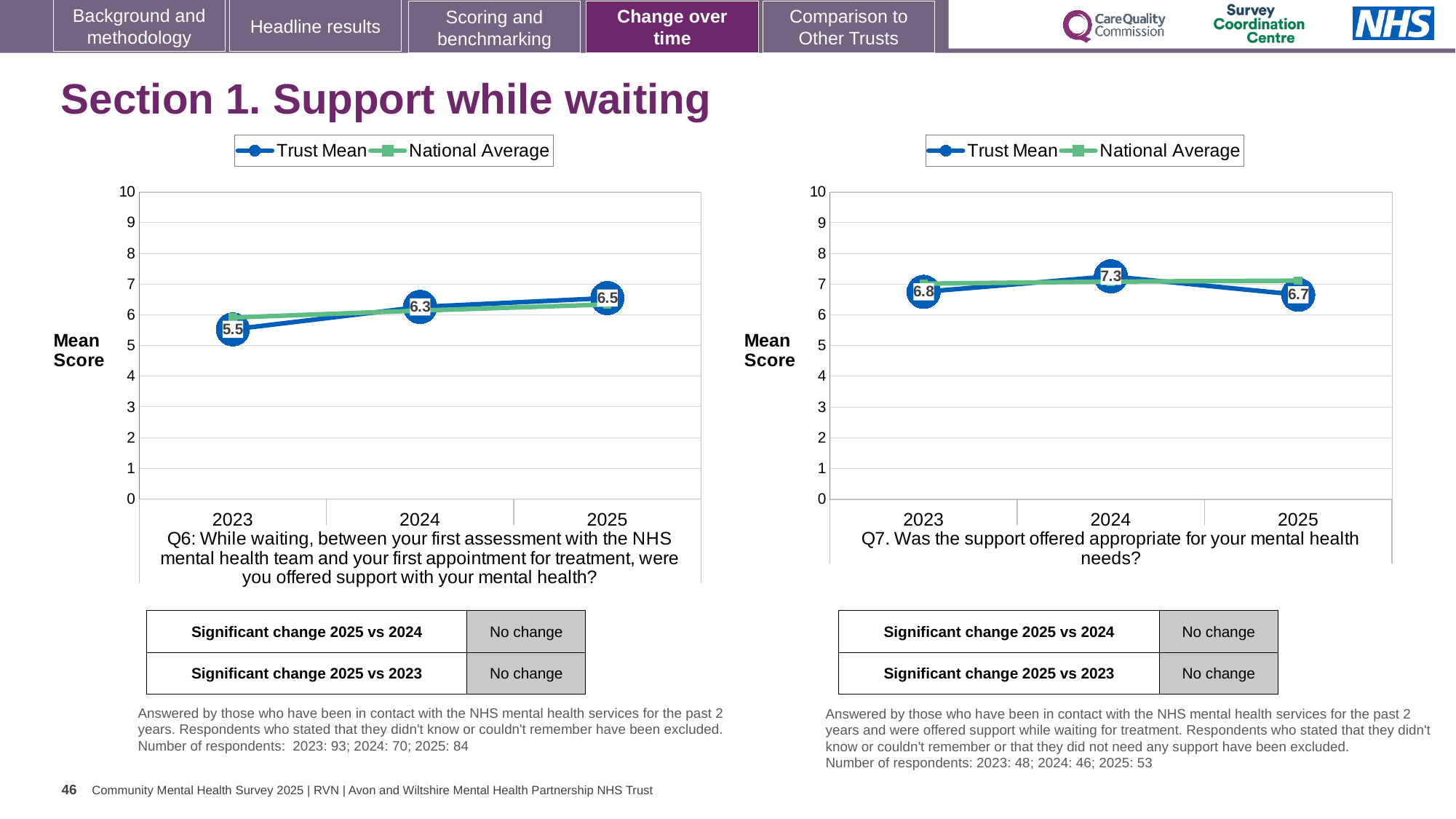
In the left chart (Q6), which year has the lowest Trust Mean score? 2023 How many years are plotted on the x axis of the left chart (Q6)? 3 In the left chart (Q6), what is the difference between the Trust Mean scores for 2025 and 2023? 1.0 In the right chart (Q7), what is the Trust Mean score for 2024? 7.3 In the left chart (Q6), what is the Trust Mean score for 2023? 5.5 How many series does the legend of the right chart (Q7) list? 2 In the right chart (Q7), which year has the highest Trust Mean score? 2024 In the left chart (Q6), does the Trust Mean score rise or fall from 2023 to 2025? rise In the right chart (Q7), is the Trust Mean score for 2024 greater or less than 7? greater What kind of chart is the right chart (Q7)? Line chart In the right chart (Q7), what is the Trust Mean score for 2025? 6.7 In the left chart (Q6), what is the Trust Mean score for 2025? 6.5